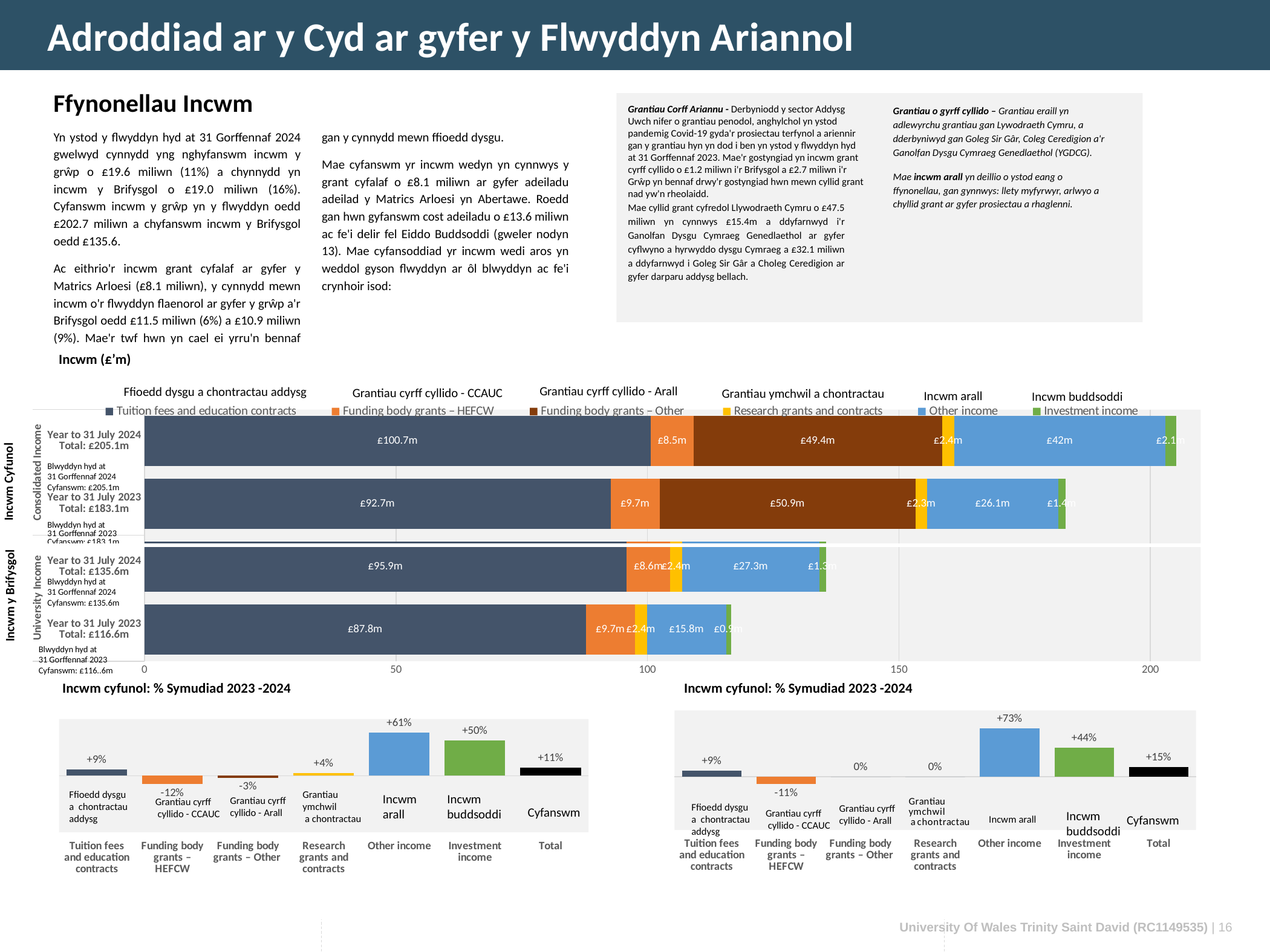
In the stacked bar chart 'Incwm (£'m)', what is the Other income value for Consolidated Income in the year to 31 July 2023? £26.1m In the stacked bar chart 'Incwm (£'m)', which is larger: Funding body grants – Other for Consolidated Income in the year to 31 July 2024 or in the year to 31 July 2023? Year to 31 July 2023 What kind of chart is the bottom-right chart 'Incwm cyfunol: % Symudiad 2023 -2024'? Bar chart In the stacked bar chart 'Incwm (£'m)', what is the total for University Income in the year to 31 July 2023? £116.6m In the stacked bar chart 'Incwm (£'m)', what is the Investment income value for University Income in the year to 31 July 2024? £1.3m In the bottom-left chart 'Incwm cyfunol: % Symudiad 2023 -2024', which category has the highest percentage change? Other income In the bottom-left chart 'Incwm cyfunol: % Symudiad 2023 -2024', what is the percentage change for Funding body grants – HEFCW? -12% In the stacked bar chart 'Incwm (£'m)', what is the difference between Consolidated Income Other income in the year to 31 July 2024 and the year to 31 July 2023? £15.9m In the stacked bar chart 'Incwm (£'m)', how many series does the legend list? 6 In the bottom-right chart 'Incwm cyfunol: % Symudiad 2023 -2024', which category has the lowest percentage change? Funding body grants – HEFCW In the stacked bar chart 'Incwm (£'m)', what is the value of Tuition fees and education contracts for Consolidated Income in the year to 31 July 2024? £100.7m In the bottom-right chart 'Incwm cyfunol: % Symudiad 2023 -2024', what is the percentage change for Total? +15%